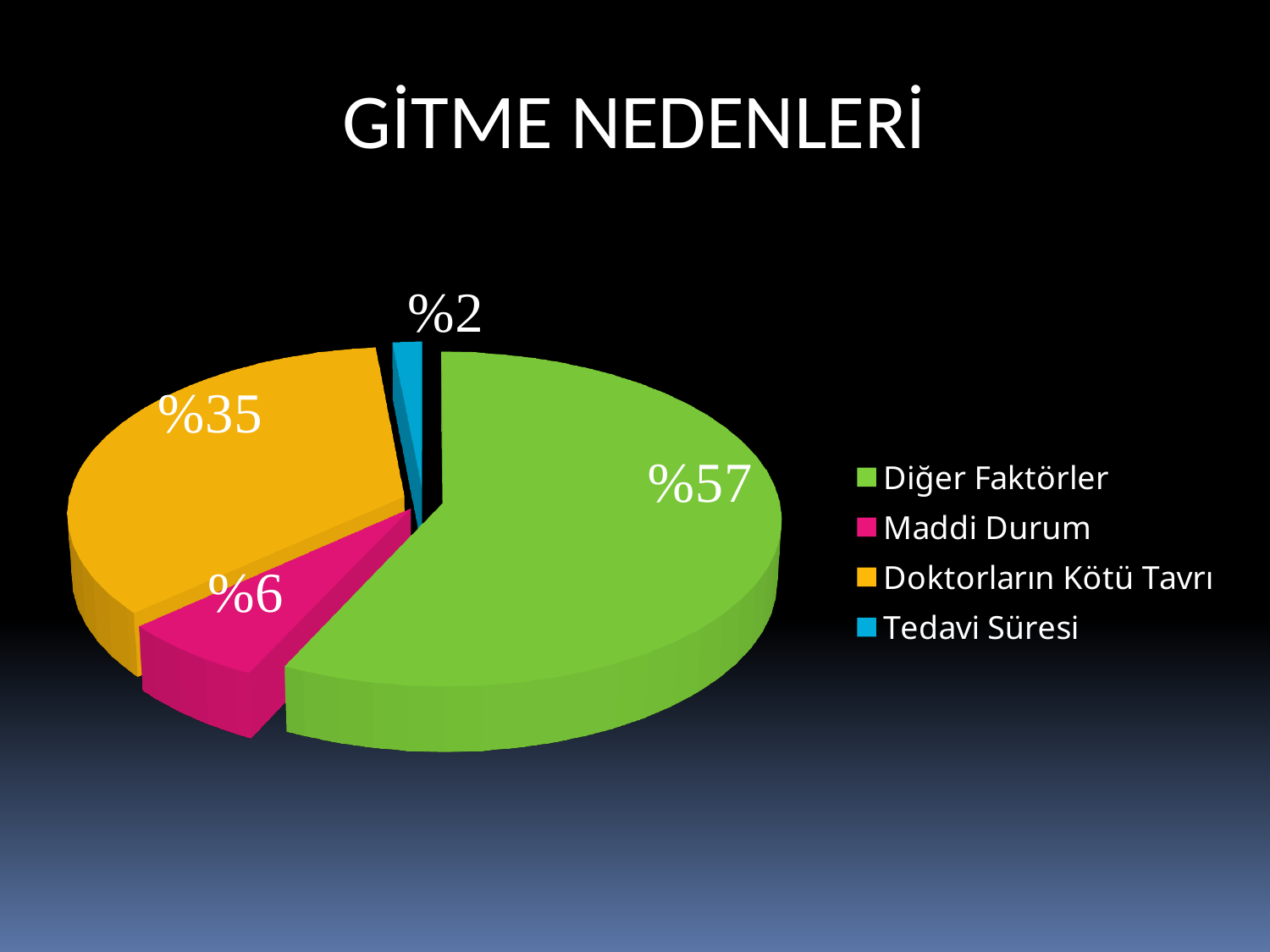
What is the value for Diğer Faktörler? %57 Which category has the smallest slice? Tedavi Süresi How many categories does the pie chart show? 4 Which category has the largest slice? Diğer Faktörler Which is larger, Maddi Durum or Tedavi Süresi? Maddi Durum What is the value for Maddi Durum? %6 Which colour represents Doktorların Kötü Tavrı in the legend? orange What is the title of the slide? GİTME NEDENLERİ What is the difference between the values for Diğer Faktörler and Doktorların Kötü Tavrı? %22 What is the value for Tedavi Süresi? %2 What is the value for Doktorların Kötü Tavrı? %35 What kind of chart is shown on the slide? pie chart